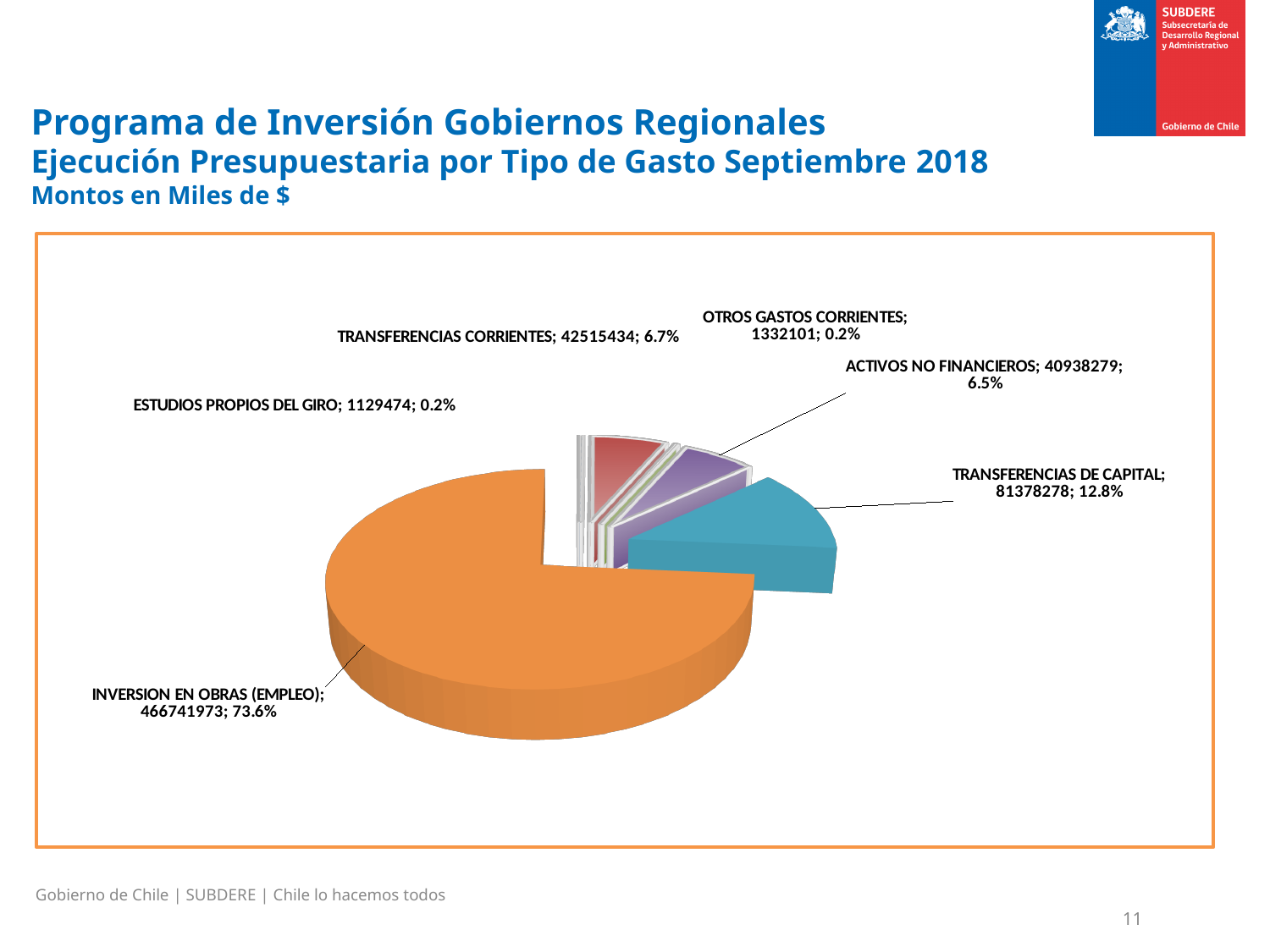
Which category has the largest slice of the pie? INVERSION EN OBRAS (EMPLEO) How many categories are shown in the pie chart? 6 What kind of chart is shown on the slide? Pie chart What is the value for ACTIVOS NO FINANCIEROS? 40938279 What is the value for TRANSFERENCIAS DE CAPITAL? 81378278 What is the difference between the values for TRANSFERENCIAS DE CAPITAL and ACTIVOS NO FINANCIEROS? 40439999 In what units are the amounts on the slide expressed? Miles de $ What share of the pie does INVERSION EN OBRAS (EMPLEO) represent? 73.6% Which is larger, the value for TRANSFERENCIAS CORRIENTES or the value for ACTIVOS NO FINANCIEROS? TRANSFERENCIAS CORRIENTES What is the value for INVERSION EN OBRAS (EMPLEO)? 466741973 What share of the pie does TRANSFERENCIAS CORRIENTES represent? 6.7% Which category has the smallest value? ESTUDIOS PROPIOS DEL GIRO